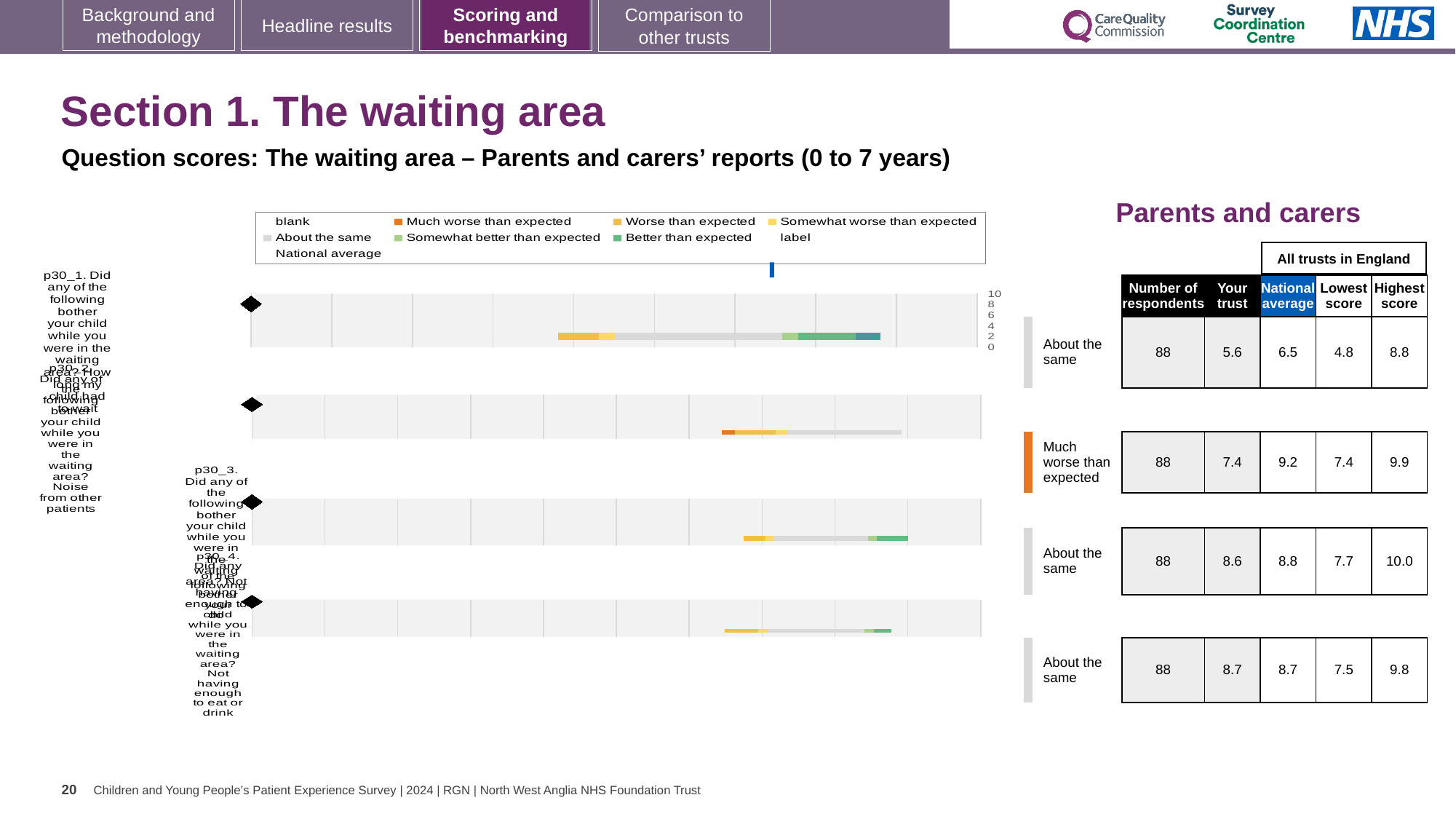
What is the 'Your trust' score for the first question row (p30_1)? 5.6 What is the national average for the second question row? 9.2 What is the highest score across all trusts in England for the third question row? 10.0 What kind of chart is shown on the slide? bar chart Which benchmark category is the second question row assigned to? Much worse than expected How many respondents are reported for each question row? 88 Which question row has the highest 'Your trust' score? the fourth row (8.7) How many question rows (bars) does the chart show? 4 Which legend entry is shown in dark orange? Much worse than expected Which question row has the lowest 'Your trust' score? the first row, p30_1 (5.6) For the first question row (p30_1), which is larger: the 'Your trust' score or the national average? the national average For the second question row, what is the difference between the national average and the 'Your trust' score? 1.8